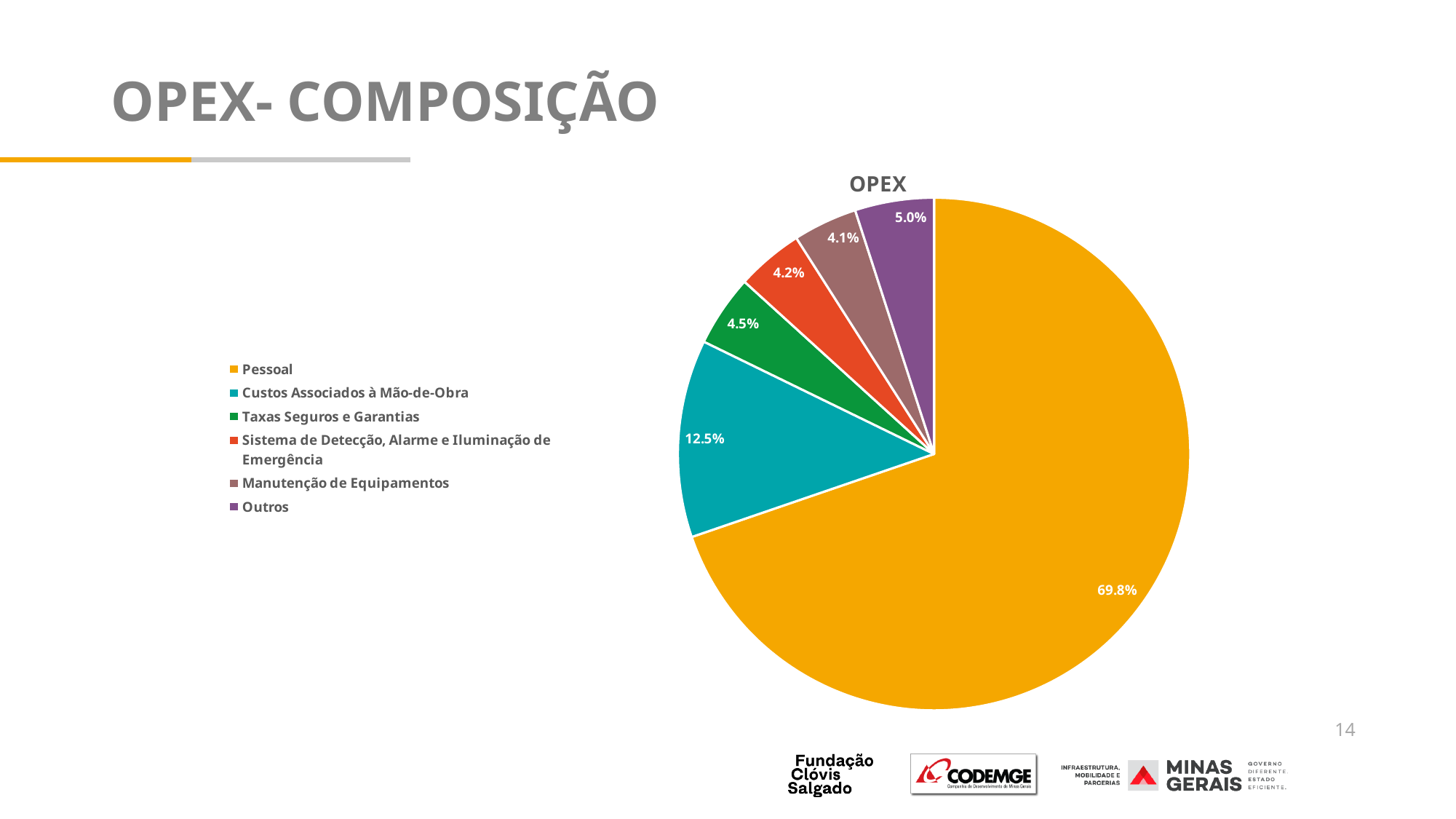
What type of chart is shown on the slide? pie chart What is the title of the chart? OPEX What percentage is shown for Sistema de Detecção, Alarme e Iluminação de Emergência? 4.2% What percentage is shown for Taxas Seguros e Garantias? 4.5% Which category has the smallest slice of the pie? Manutenção de Equipamentos How many categories does the legend list? 6 Which category has the largest slice of the pie? Pessoal What is the difference in percentage points between Pessoal and Custos Associados à Mão-de-Obra? 57.3 What percentage is shown for Manutenção de Equipamentos? 4.1% What share of OPEX does Pessoal represent? 69.8% What share of OPEX is Custos Associados à Mão-de-Obra? 12.5% What percentage is shown for Outros? 5.0%